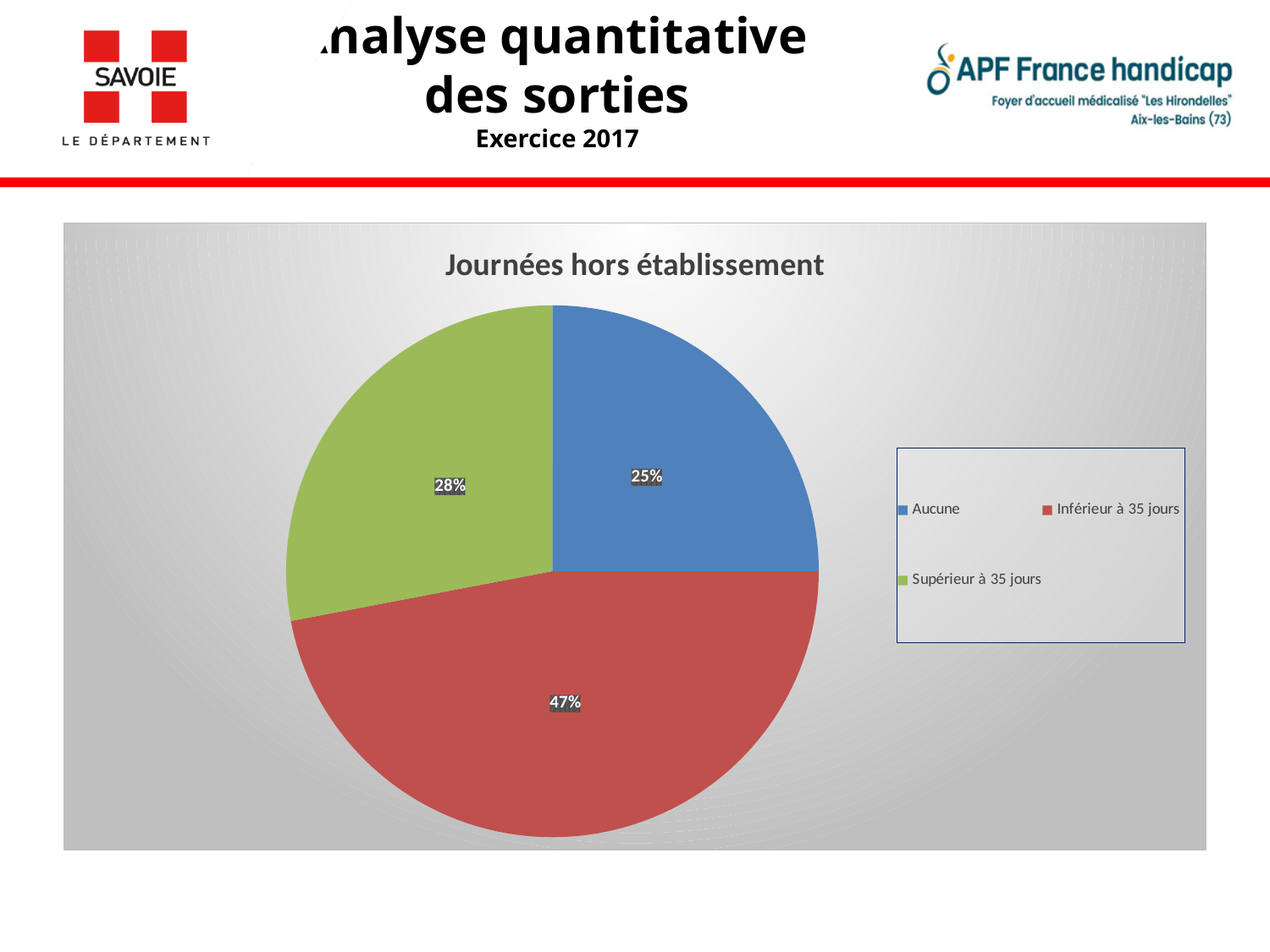
What share of the pie does "Aucune" represent? 25% Which category has the largest slice of the pie? Inférieur à 35 jours What share of the pie does "Supérieur à 35 jours" represent? 28% What type of chart is shown on the slide? Pie chart What is the title of the chart? Journées hors établissement Which is larger, the slice for "Supérieur à 35 jours" or the slice for "Aucune"? Supérieur à 35 jours What is the difference in percentage points between "Inférieur à 35 jours" and "Aucune"? 22 percentage points How many categories does the pie chart show? 3 Which category has the smallest slice of the pie? Aucune What share of the pie does "Inférieur à 35 jours" represent? 47% What is the difference in percentage points between "Inférieur à 35 jours" and "Supérieur à 35 jours"? 19 percentage points What colour is the slice for "Inférieur à 35 jours"? Red